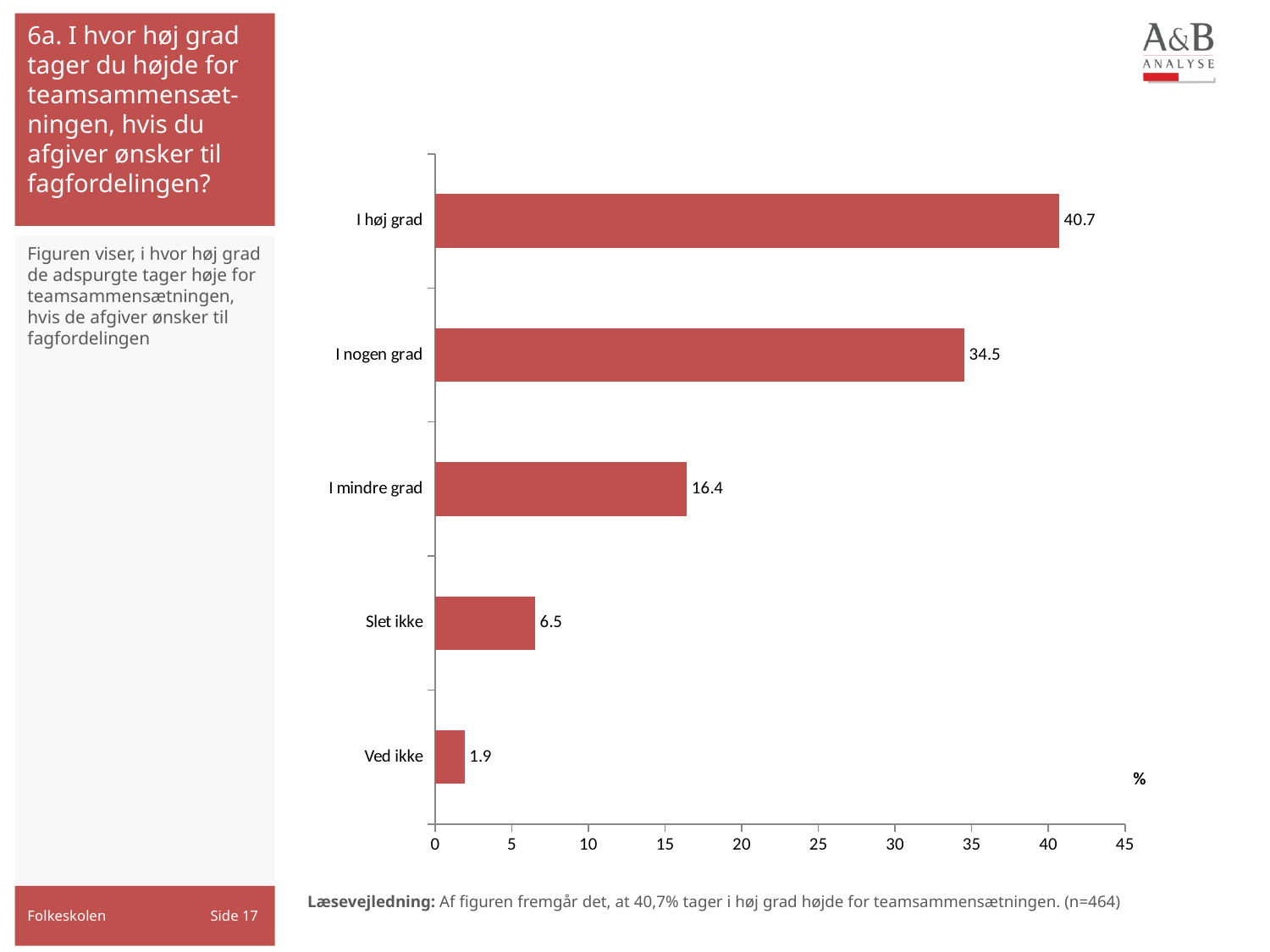
Which is larger, the value for "I mindre grad" or the value for "Slet ikke"? I mindre grad Which category has the highest value? I høj grad What is the value for "I høj grad"? 40.7 What is the difference between the values for "I høj grad" and "I nogen grad"? 6.2 What is the value for "Ved ikke"? 1.9 What kind of chart is shown on the slide? bar chart Is the value for "I mindre grad" greater or less than 20? less Which category has the lowest value? Ved ikke What is the maximum value shown on the horizontal axis? 45 How many categories are shown in the chart? 5 What is the value for "I nogen grad"? 34.5 What is the value for "Slet ikke"? 6.5